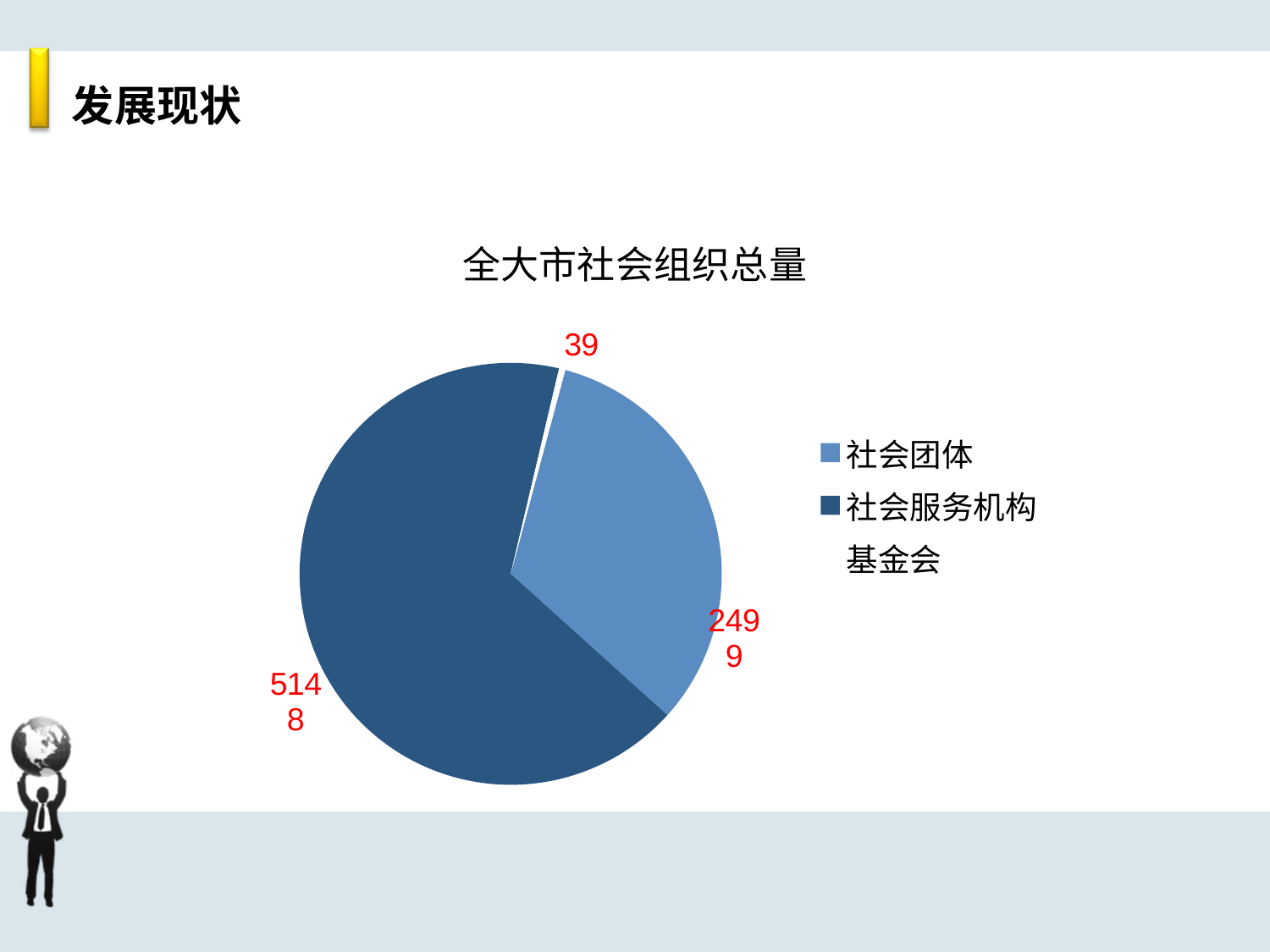
What is the title of the pie chart? 全大市社会组织总量 Which legend entry is shown in the lighter blue colour? 社会团体 Which is larger, the value for 社会团体 or the value for 基金会? 社会团体 Which category has the smallest slice in the pie chart? 基金会 What is the value for 社会服务机构 in the pie chart? 5148 What type of chart is shown on the slide? pie chart What is the value for 社会团体 in the pie chart? 2499 What is the value for 基金会 in the pie chart? 39 How many categories does the pie chart have? 3 Which category has the largest slice in the pie chart? 社会服务机构 What is the total of all three values in the pie chart? 7686 What is the difference between the values for 社会服务机构 and 社会团体? 2649